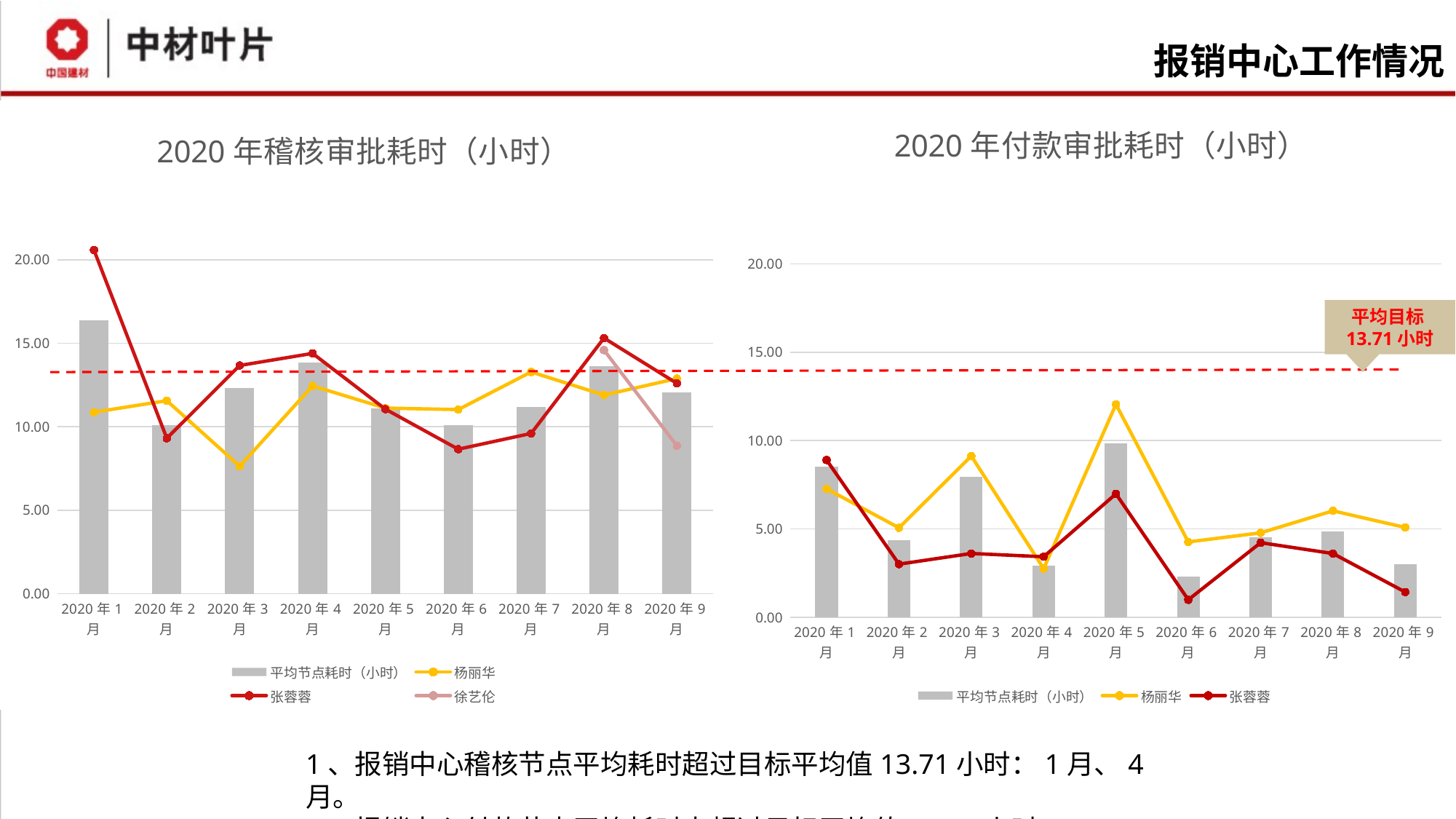
On the 2020年付款审批耗时（小时） chart, is the 杨丽华 value for 2020年5月 greater or less than 10.00? greater On the 2020年付款审批耗时（小时） chart, how many series does the legend list? 3 On the 2020年付款审批耗时（小时） chart, is the 张蓉蓉 value for 2020年6月 greater or less than 5.00? less On the 2020年付款审批耗时（小时） chart, in which month is the 平均节点耗时（小时） bar highest? 2020年5月 On the 2020年稽核审批耗时（小时） chart, in 2020年1月, which is larger: 张蓉蓉 or 杨丽华? 张蓉蓉 On the 2020年稽核审批耗时（小时） chart, in which month is the 平均节点耗时（小时） bar highest? 2020年1月 On the 2020年付款审批耗时（小时） chart, does the 张蓉蓉 line rise or fall from 2020年7月 to 2020年9月? fall On the 2020年稽核审批耗时（小时） chart, is the 张蓉蓉 value for 2020年1月 greater or less than 15.00? greater On the 2020年稽核审批耗时（小时） chart, how many series does the legend list? 4 On the 2020年稽核审批耗时（小时） chart, how many months are shown on the x axis? 9 What target value is shown in the callout next to the dashed red line? 13.71 小时